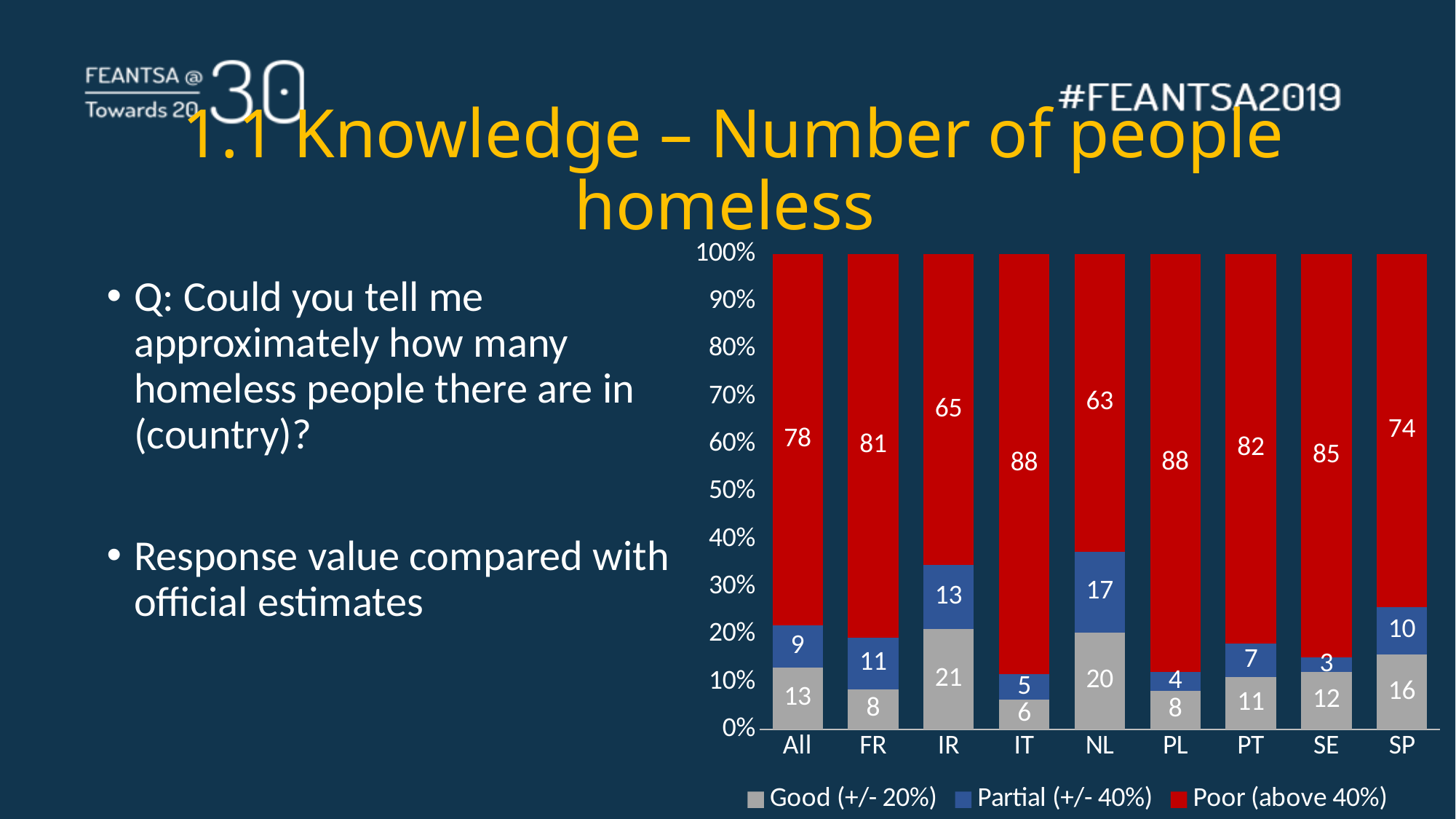
How many series does the legend list? 3 What is the Poor (above 40%) value for NL? 63 What is the difference between the Poor (above 40%) values for SE and SP? 11 What is the Good (+/- 20%) value for IR? 21 Which is larger, the Good (+/- 20%) value for SP or for PT? SP Which category has the lowest Poor (above 40%) value? NL How many categories are shown on the x axis? 9 What is the total of the stacked bar for NL? 100 Which category has the highest Good (+/- 20%) value? IR What kind of chart is shown on the slide? Stacked bar chart What is the Partial (+/- 40%) value for SE? 3 Which category has the highest Partial (+/- 40%) value? NL